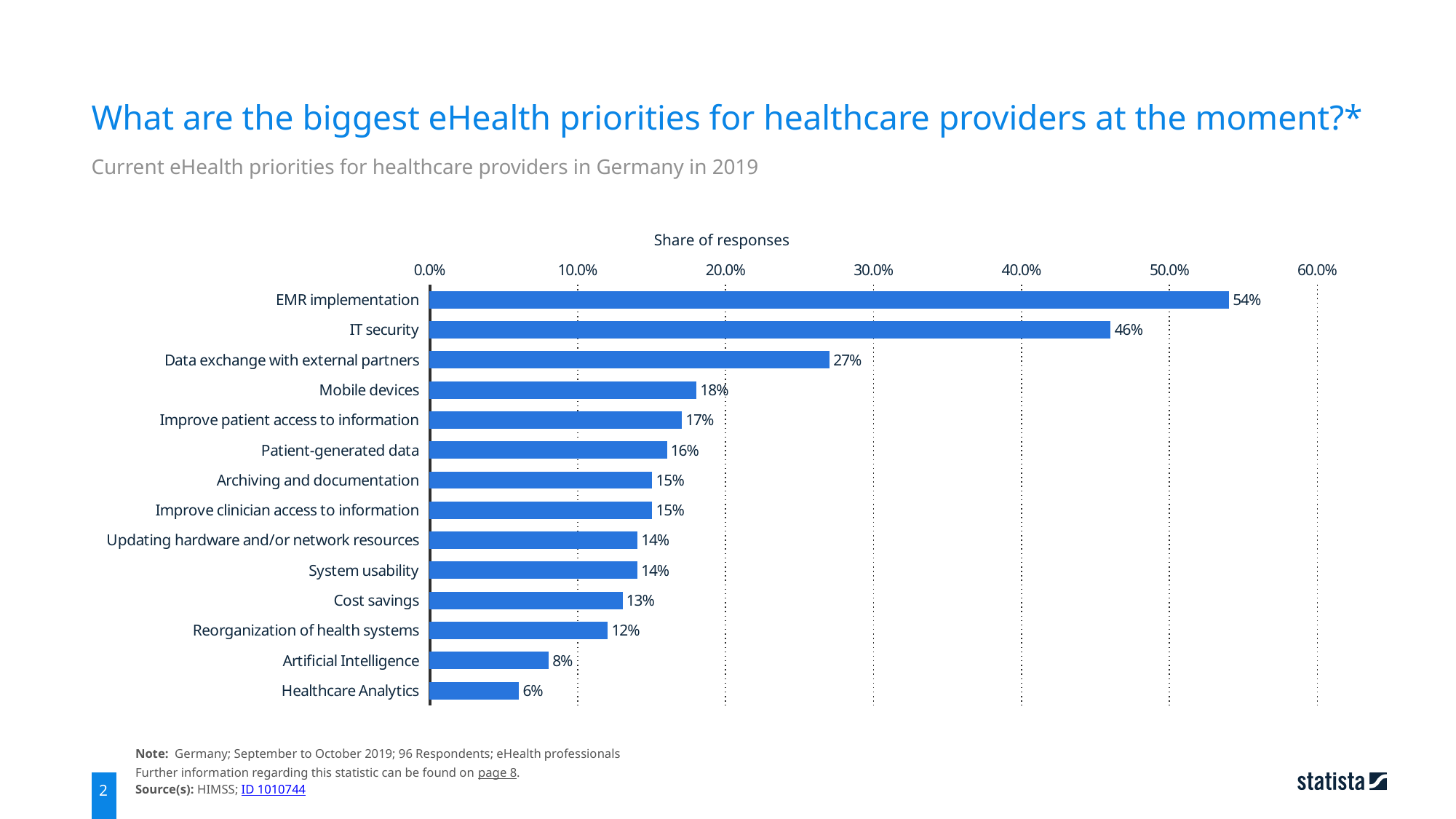
What is the share of responses for IT security? 46% Is the value for Data exchange with external partners greater or less than 30.0%? less What is the label of the horizontal axis? Share of responses Which has a larger share of responses, Cost savings or Reorganization of health systems? Cost savings Which category has the lowest share of responses? Healthcare Analytics How many categories are shown in the chart? 14 What is the share of responses for EMR implementation? 54% What kind of chart is shown on the slide? Bar chart What is the difference in share of responses between Data exchange with external partners and Mobile devices? 9% What is the difference in share of responses between EMR implementation and IT security? 8% What is the share of responses for Artificial Intelligence? 8% Which category has the highest share of responses? EMR implementation